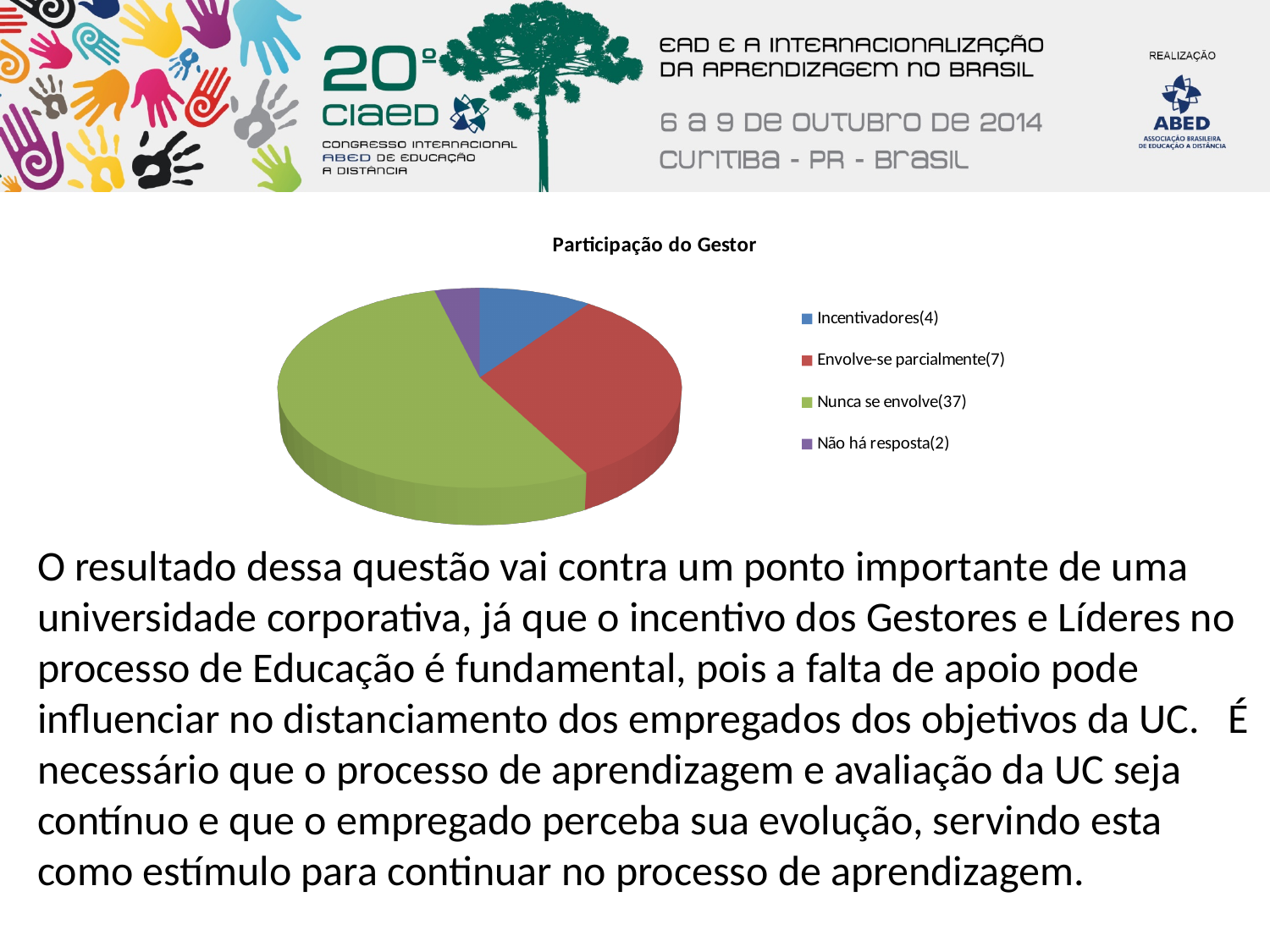
What is the value for Nunca se envolve? 37 What share of the pie does Nunca se envolve represent? 74% What is the value for Não há resposta? 2 What is the value for Envolve-se parcialmente? 7 Which category has the largest slice of the pie? Nunca se envolve What is the difference between the values for Nunca se envolve and Envolve-se parcialmente? 30 What is the value for Incentivadores? 4 Which is larger, the value for Incentivadores or the value for Envolve-se parcialmente? Envolve-se parcialmente What is the title of the chart? Participação do Gestor How many categories does the pie chart have? 4 Which category has the smallest slice of the pie? Não há resposta What kind of chart is shown on the slide? pie chart